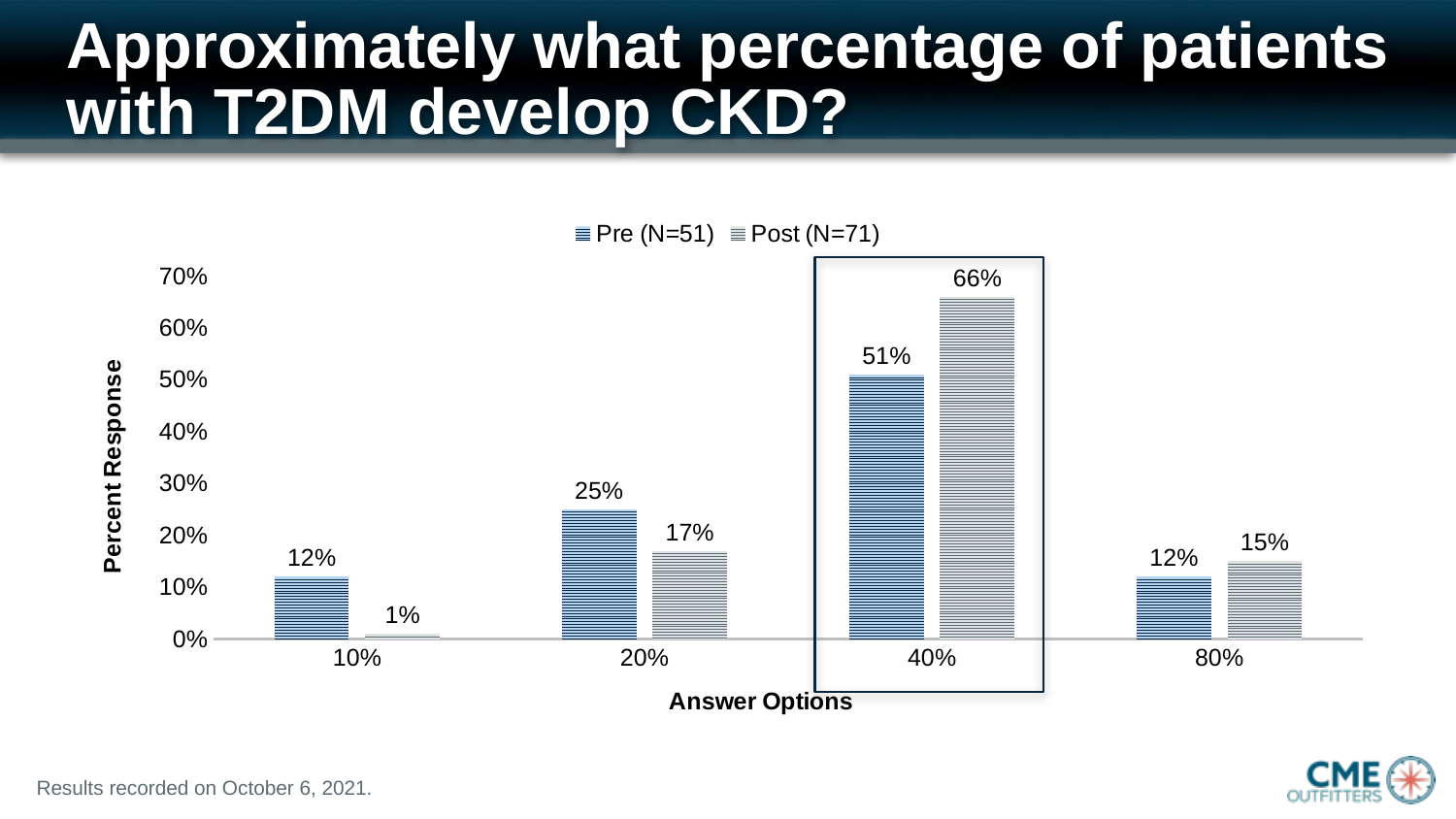
What is the difference between the Post (N=71) and Pre (N=51) values for the 40% answer option? 15% Which answer option has the highest Post (N=71) value? 40% For the 20% answer option, which series has the larger value, Pre (N=51) or Post (N=71)? Pre (N=51) What is the label of the y axis? Percent Response Which answer option is outlined with a box on the chart? 40% What is the Pre (N=51) value for the 40% answer option? 51% How many series does the legend list? 2 How many answer options are shown on the x axis? 4 What kind of chart is shown on the slide? Bar chart What is the Post (N=71) value for the 10% answer option? 1% What is the Post (N=71) value for the 20% answer option? 17% Which answer option has the lowest Pre (N=51) value? 10% or 80% (both 12%)